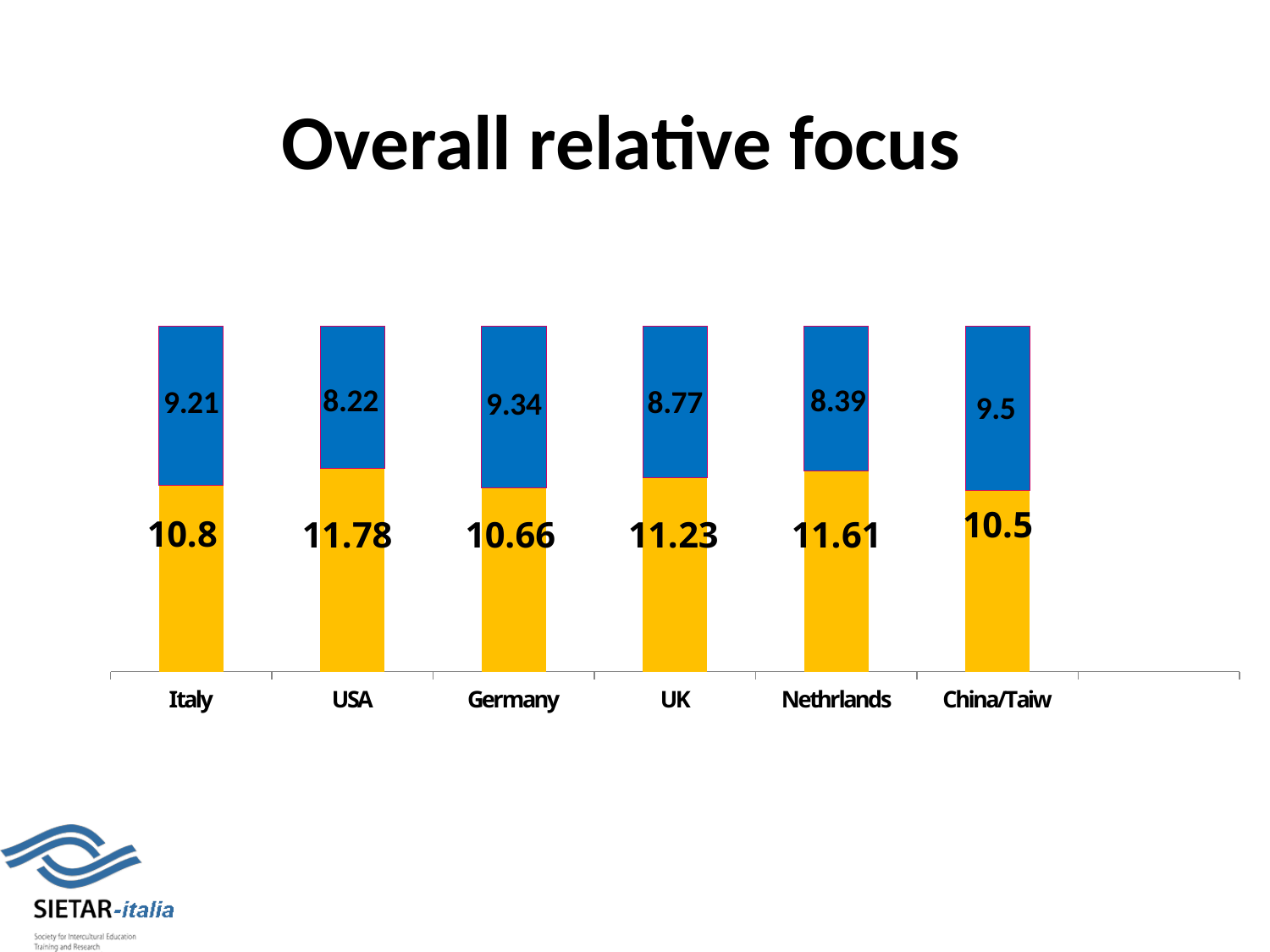
How many categories are shown on the x axis? 6 What is the value of the blue segment for Germany? 9.34 Which category has the highest blue segment value? China/Taiw Which has a larger yellow segment value, UK or Nethrlands? Nethrlands What is the value of the yellow segment for USA? 11.78 What kind of chart is shown on the slide? Stacked bar chart What is the total of the stacked bar for UK? 20 Which category has the lowest yellow segment value? China/Taiw What is the value of the blue segment for Nethrlands? 8.39 What is the title of the chart? Overall relative focus Which category has the highest yellow segment value? USA What is the difference between the yellow and blue segment values for Italy? 1.59